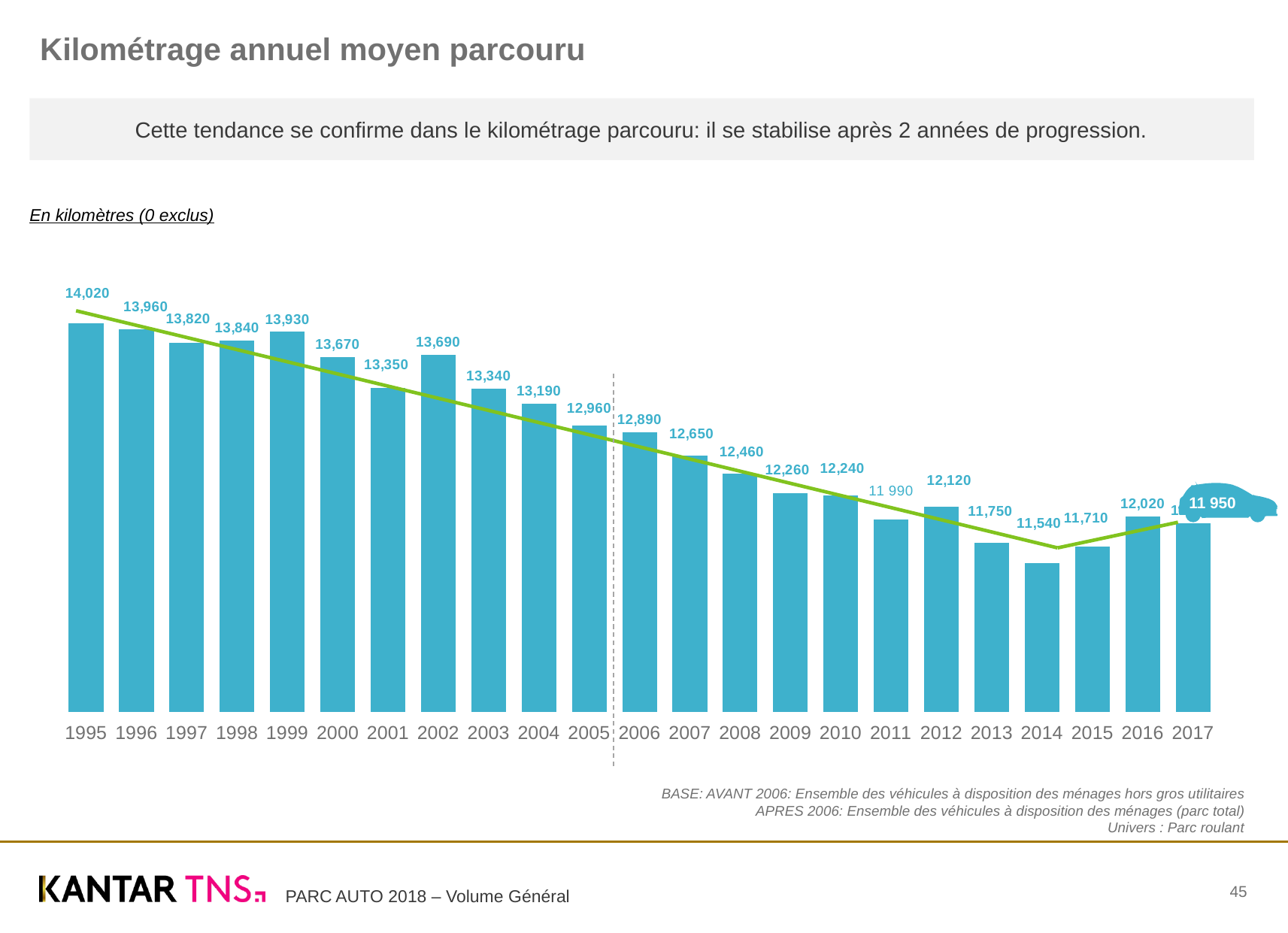
Which year has the lowest average annual mileage? 2014 What is the difference between the values for 1995 and 2014? 2,480 What value is shown for 2008? 12,460 What value is shown for 2014? 11,540 Which year has the highest average annual mileage? 1995 What kind of chart is used to show the annual mileage? Bar chart What value is shown for 2011? 11 990 Which year has the larger value, 2001 or 2002? 2002 Do the values generally rise or fall from 1995 to 2014? Fall What is the average annual mileage shown for 1995? 14,020 What is the difference between the values for 2016 and 2015? 310 How many years are shown on the x axis? 23